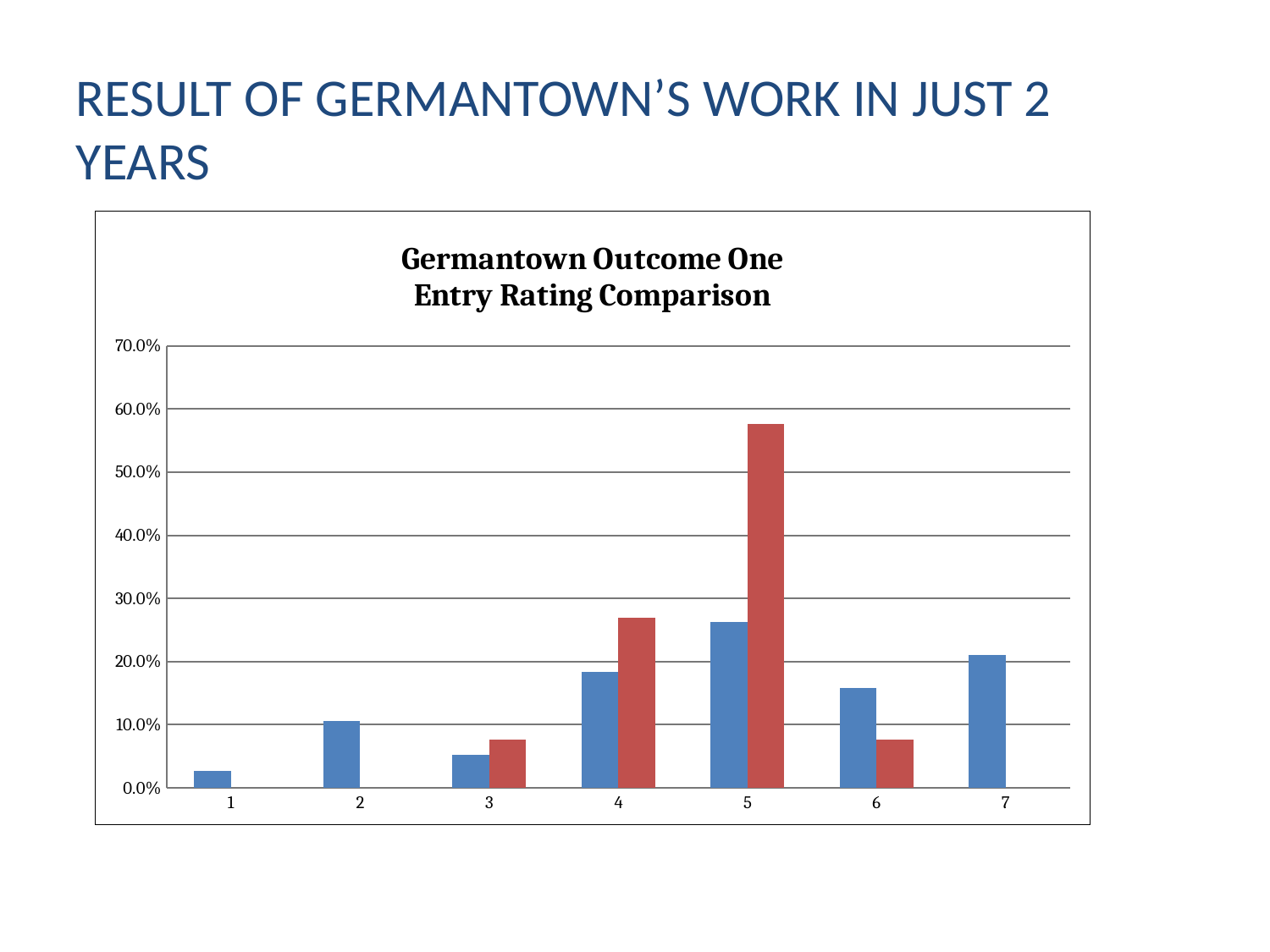
What kind of chart is shown on the slide? bar chart How many categories are shown on the x axis of the chart? 7 For category 4, which bar is taller, the blue bar or the red bar? the red bar Is the value of the blue bar for category 5 greater or less than 30.0%? less Is the value of the red bar for category 5 greater or less than 50.0%? greater How many categories have a visible red bar? 4 For category 6, which bar is taller, the blue bar or the red bar? the blue bar What is the title of the chart? Germantown Outcome One Entry Rating Comparison For which category is the blue bar the tallest? 5 For which category is the blue bar the shortest? 1 Is the value of the red bar for category 3 greater or less than 10.0%? less For which category is the red bar the tallest? 5